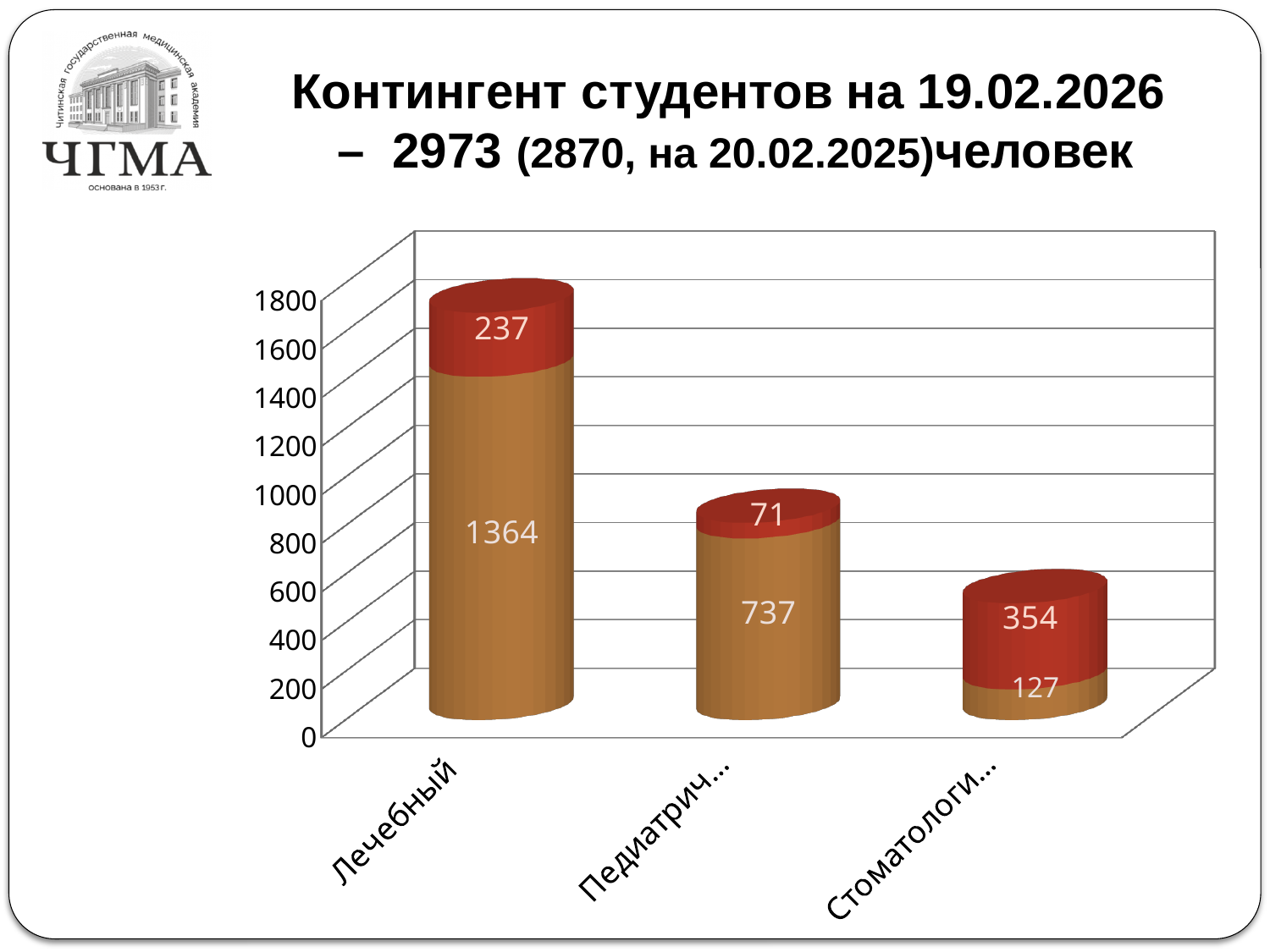
What is the value of the upper (red) segment of the bar for Стоматологи...? 354 What is the total of the stacked bar for Стоматологи...? 481 Which category has the shortest stacked bar? Стоматологи... What is the value of the lower (brown) segment of the bar for Лечебный? 1364 What is the value of the lower (brown) segment of the bar for Педиатрич...? 737 Which category has the tallest stacked bar? Лечебный What is the value of the upper (red) segment of the bar for Лечебный? 237 Which is larger: the upper (red) segment for Стоматологи... or the upper (red) segment for Лечебный? Стоматологи... What is the total of the stacked bar for Лечебный? 1601 How many categories are shown on the x axis of the chart? 3 What is the difference between the lower (brown) segment values for Лечебный and Педиатрич...? 627 What kind of chart is shown on the slide? Stacked bar chart